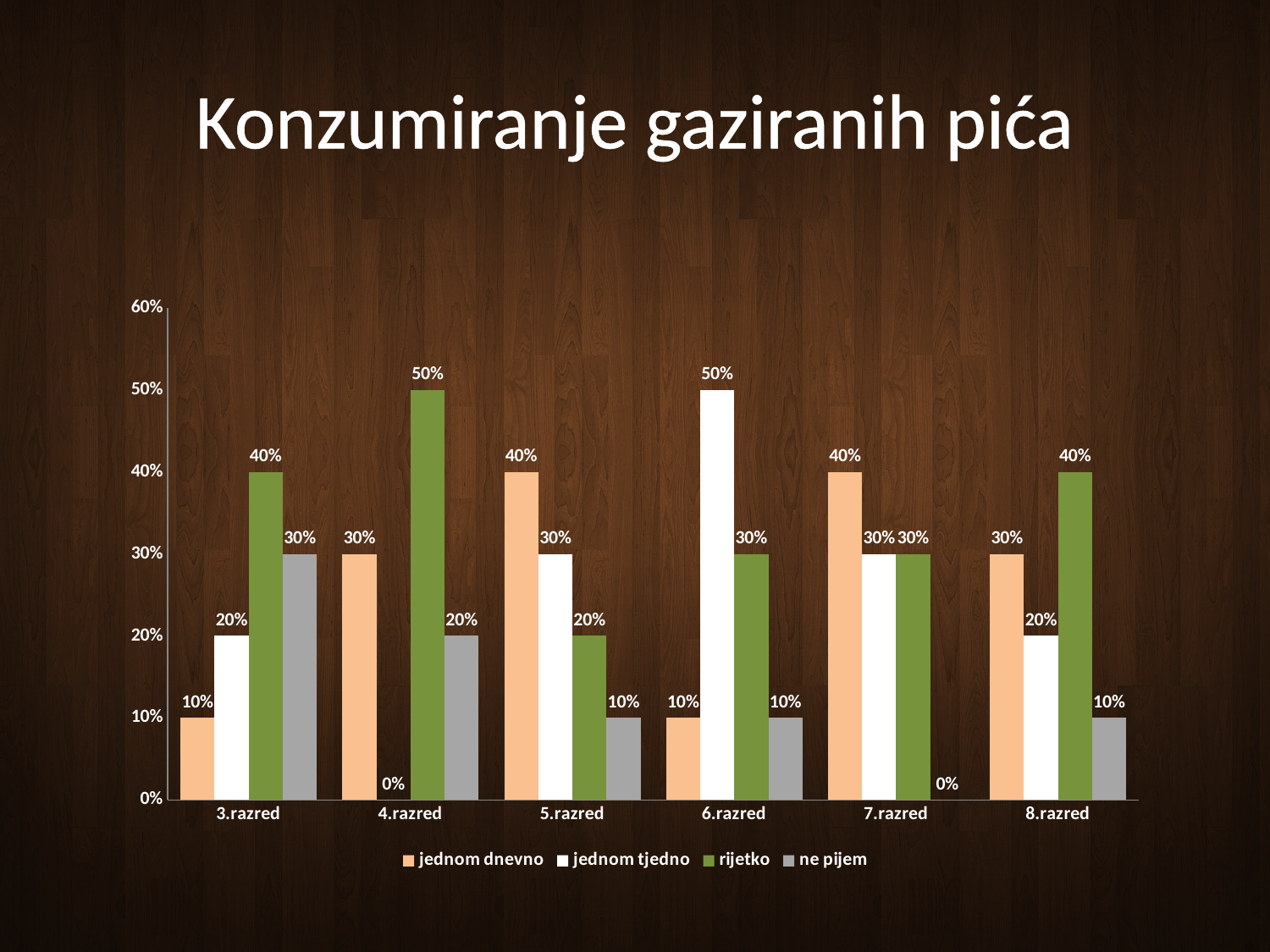
What is the value for "jednom dnevno" in 5.razred? 40% What is the title of the slide? Konzumiranje gaziranih pića What is the value for "jednom tjedno" in 6.razred? 50% What kind of chart is shown on the slide? bar chart How many categories (razredi) are shown on the x axis? 6 What is the value for "ne pijem" in 7.razred? 0% Which is larger in 3.razred: "rijetko" or "ne pijem"? rijetko Which category has the lowest value for "jednom tjedno"? 4.razred What is the difference between "jednom tjedno" and "jednom dnevno" in 6.razred? 40% Which category has the highest value for "rijetko"? 4.razred What is the value for "rijetko" in 4.razred? 50% How many series does the legend list? 4